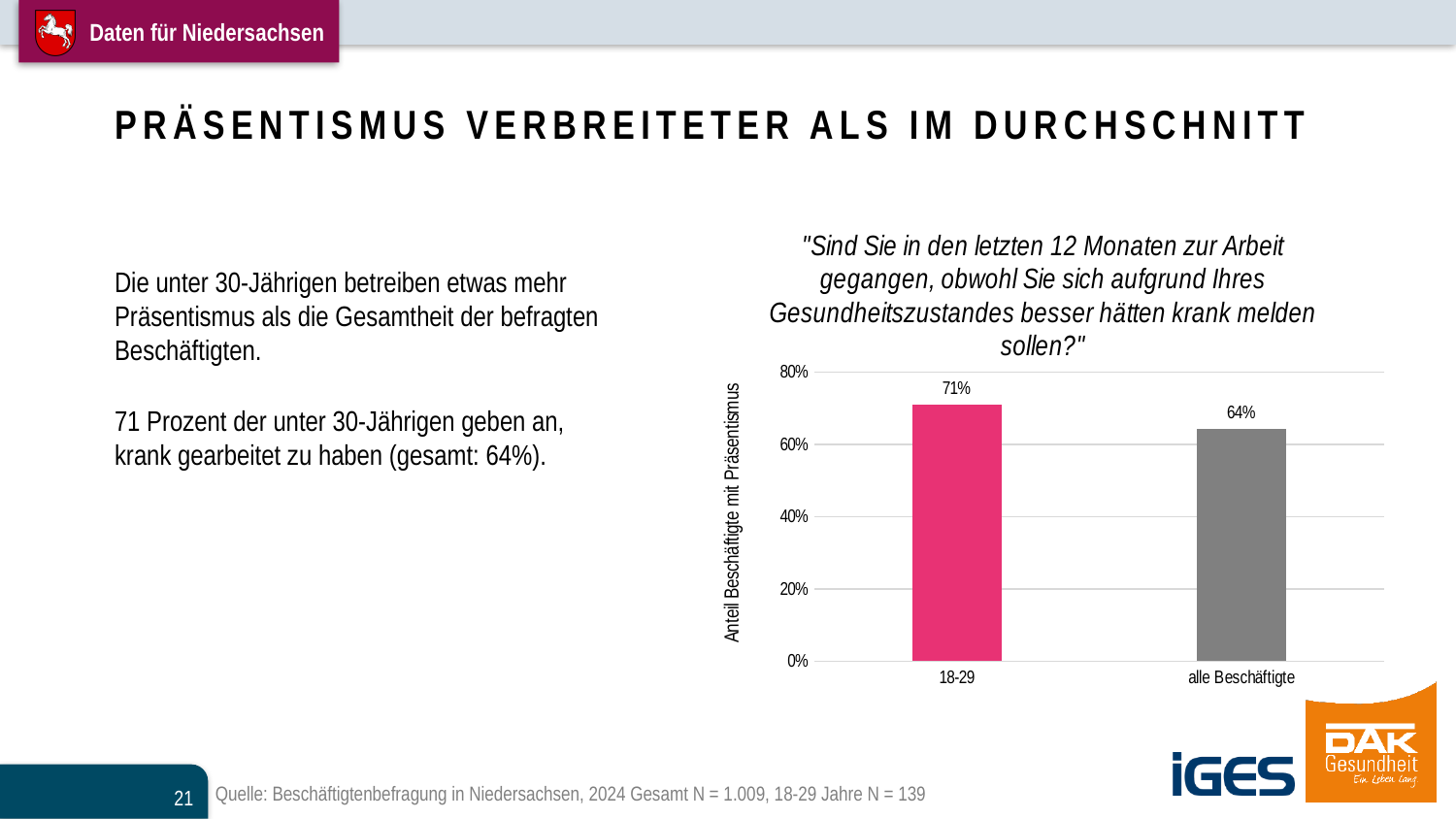
Which category has the lowest value? alle Beschäftigte Which category has the highest value? 18-29 What colour is the bar for the 18-29 category? pink How many categories are shown on the x axis? 2 Is the value for alle Beschäftigte greater or less than 60%? greater Which is larger, the value for 18-29 or the value for alle Beschäftigte? 18-29 What is the value for the 18-29 category? 71% What is the difference between the values for 18-29 and alle Beschäftigte? 7 percentage points Is the value for 18-29 greater or less than 80%? less What is the value for alle Beschäftigte? 64% What is the label of the vertical axis? Anteil Beschäftigte mit Präsentismus What kind of chart is shown on the slide? bar chart